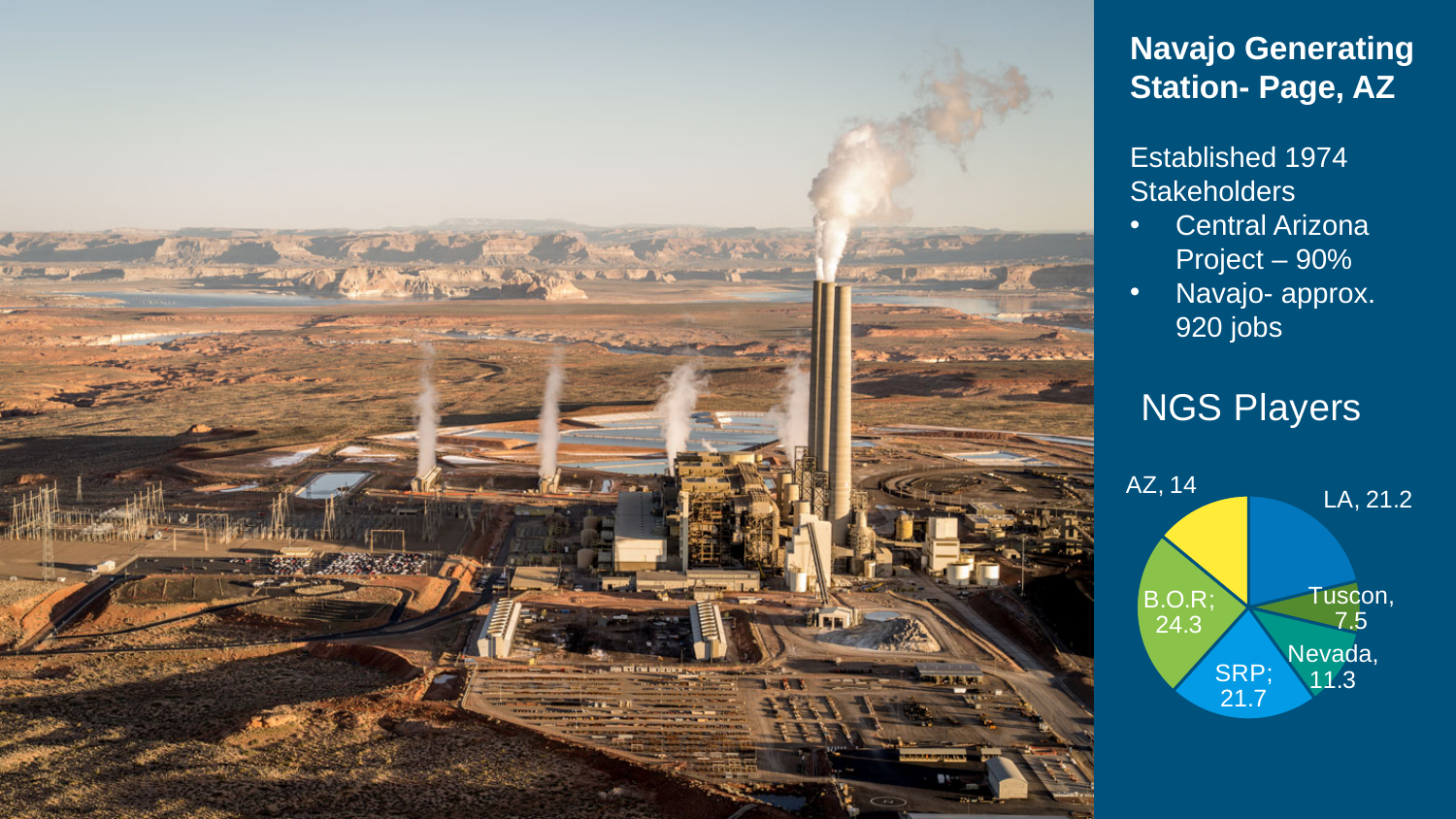
In the NGS Players pie chart, what is the value for AZ? 14 What is the title of the pie chart on the slide? NGS Players In the NGS Players pie chart, what is the difference between the values for B.O.R and Tuscon? 16.8 In the NGS Players pie chart, which is larger, the value for AZ or the value for Nevada? AZ In the NGS Players pie chart, what is the difference between the values for SRP and Nevada? 10.4 In the NGS Players pie chart, what is the value for LA? 21.2 Which slice of the NGS Players pie chart has the largest value? B.O.R In the NGS Players pie chart, what is the value for Nevada? 11.3 How many slices does the NGS Players pie chart have? 6 Which slice of the NGS Players pie chart has the smallest value? Tuscon What type of chart is shown under the heading NGS Players? pie chart In the NGS Players pie chart, what is the value for B.O.R? 24.3